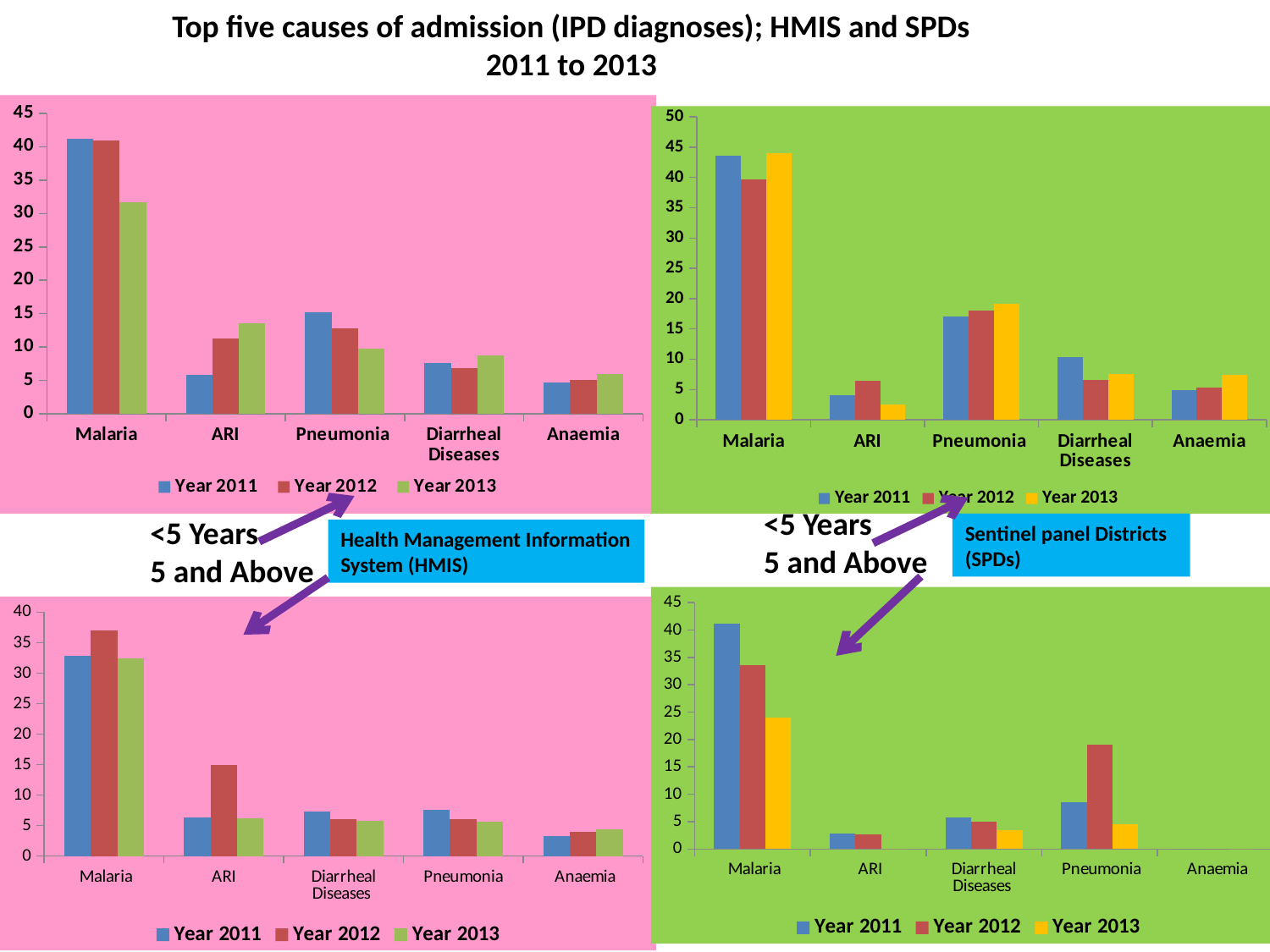
What kind of chart is the top-left chart on the slide? Bar chart In the top-right chart, what colour represents the Year 2013 series? Yellow In the top-right chart, which is larger for ARI: the Year 2012 value or the Year 2013 value? Year 2012 In the top-right chart, is the Year 2013 value for Pneumonia greater or less than 15? greater In the top-left chart, which category has the highest Year 2011 value? Malaria In the bottom-right chart, do the Malaria values rise or fall from Year 2011 to Year 2013? fall In the top-right chart, how many series does the legend list? 3 In the bottom-left chart, is the Year 2012 value for ARI greater or less than 10? greater In the bottom-left chart, how many categories are shown on the x axis? 5 In the bottom-left chart, which category has the lowest Year 2011 value? Anaemia In the top-left chart, is the Year 2013 value for Malaria greater or less than 35? less In the bottom-right chart, which is larger for Pneumonia: the Year 2011 value or the Year 2012 value? Year 2012